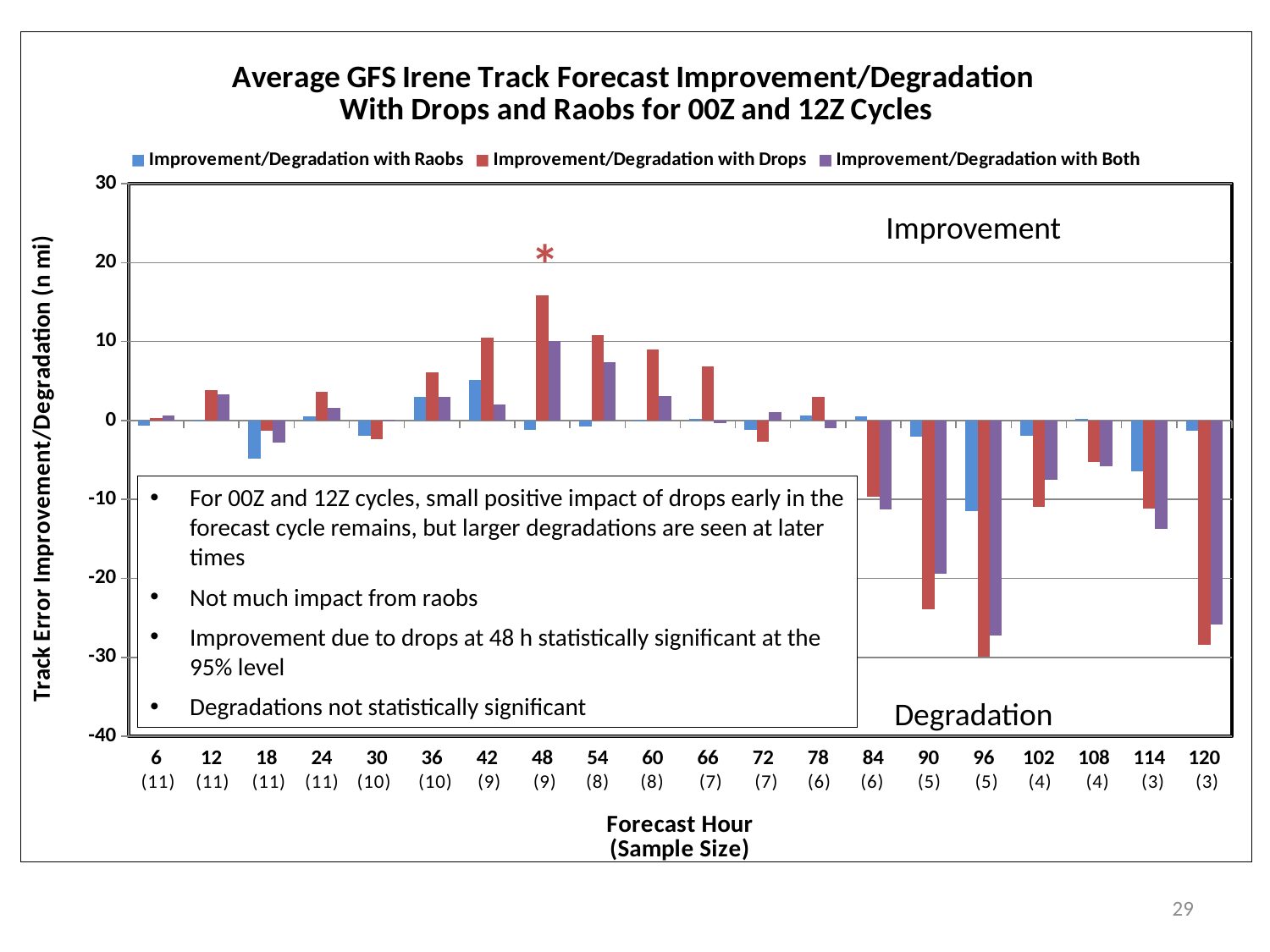
How many forecast hours are shown along the x axis? 20 Is the Improvement/Degradation with Raobs value at forecast hour 96 greater or less than -5? less At which forecast hour is the Improvement/Degradation with Drops value highest? 48 Is the Improvement/Degradation with Drops value at forecast hour 96 greater or less than -20? less What colour represents Improvement/Degradation with Drops in the legend? red How many series does the legend list? 3 What kind of chart is shown on the slide? bar chart At forecast hour 48, which is larger: the Improvement/Degradation with Drops value or the Improvement/Degradation with Both value? Improvement/Degradation with Drops Is the Improvement/Degradation with Drops value at forecast hour 48 greater or less than 10? greater From forecast hour 48 to forecast hour 96, do the Improvement/Degradation with Drops values rise or fall? fall At which forecast hour is the Improvement/Degradation with Drops value lowest? 96